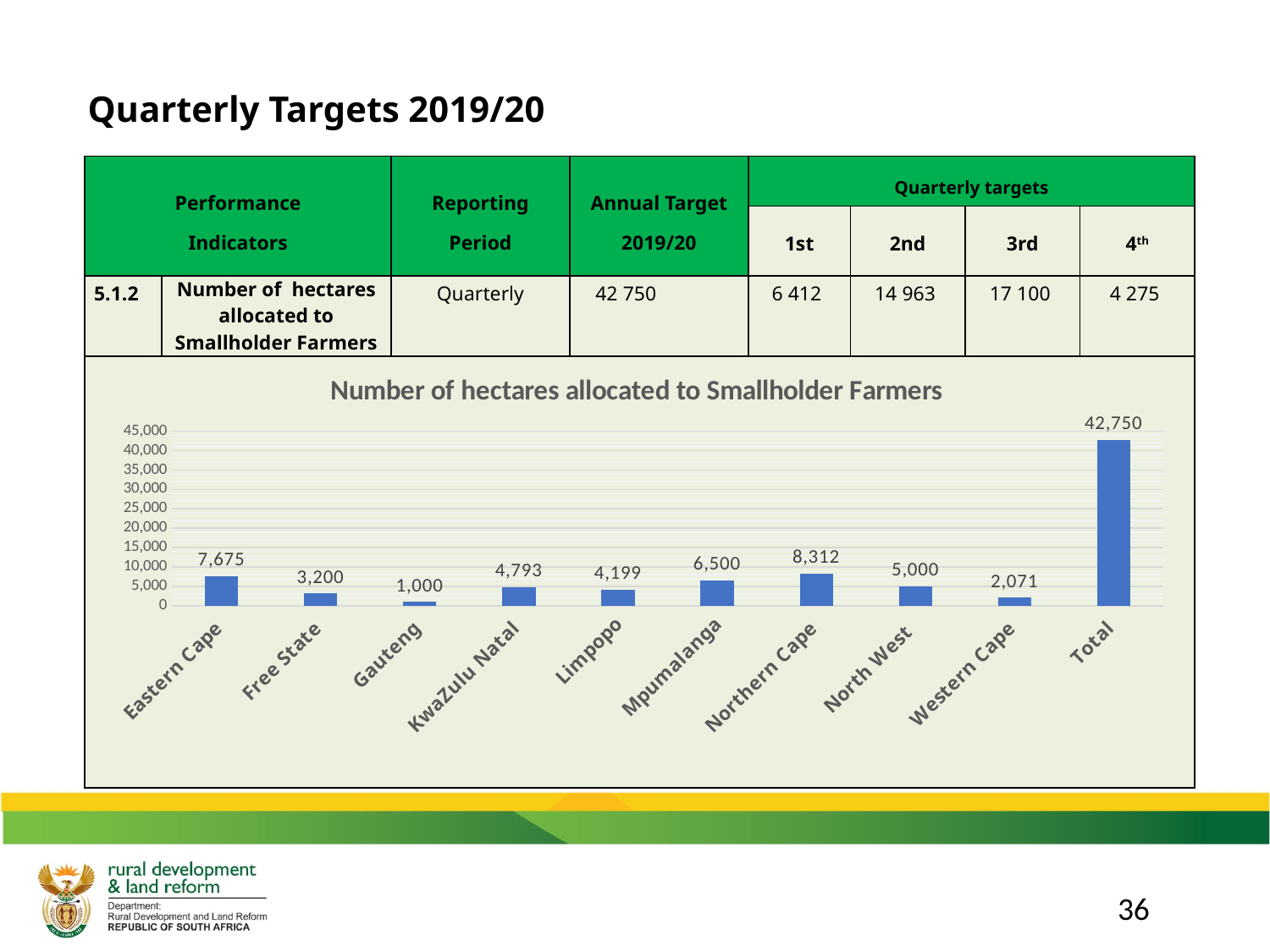
What is the value shown for Total in the chart? 42,750 What is the value for Eastern Cape in the chart? 7,675 What kind of chart is shown on the slide? bar chart What is the value for Gauteng in the chart? 1,000 Excluding the Total bar, which province has the highest number of hectares allocated? Northern Cape What is the value for Northern Cape in the chart? 8,312 Which is larger, the value for Free State or the value for KwaZulu Natal? KwaZulu Natal How many bars are shown in the chart, including the Total bar? 10 What is the title of the chart? Number of hectares allocated to Smallholder Farmers What is the difference between the values for Mpumalanga and Limpopo? 2,301 Which province has the lowest number of hectares allocated? Gauteng Is the value for North West greater or less than 10,000? less